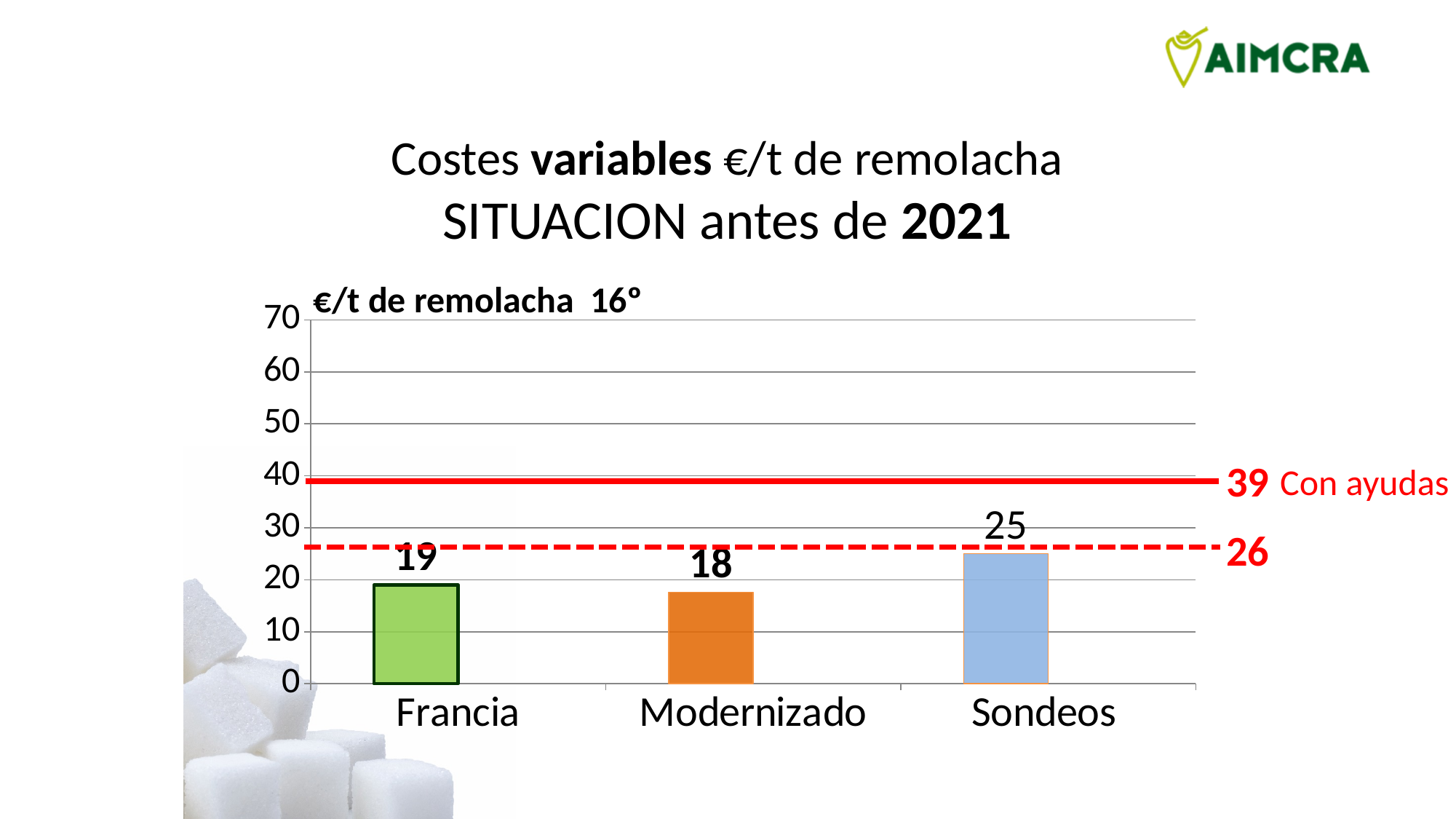
What is the value for Francia? 19 What value is marked by the dashed red line? 26 What kind of chart is shown on the slide? bar chart What is the value for Sondeos? 25 Which is larger, the value for Francia or the value for Sondeos? Sondeos Which category has the highest value? Sondeos What is the value for Modernizado? 18 Is the value for Sondeos greater or less than 30? less What value is marked by the solid red line labelled 'Con ayudas'? 39 What is the difference between the values for Sondeos and Modernizado? 7 How many categories are shown on the x axis? 3 Which category has the lowest value? Modernizado